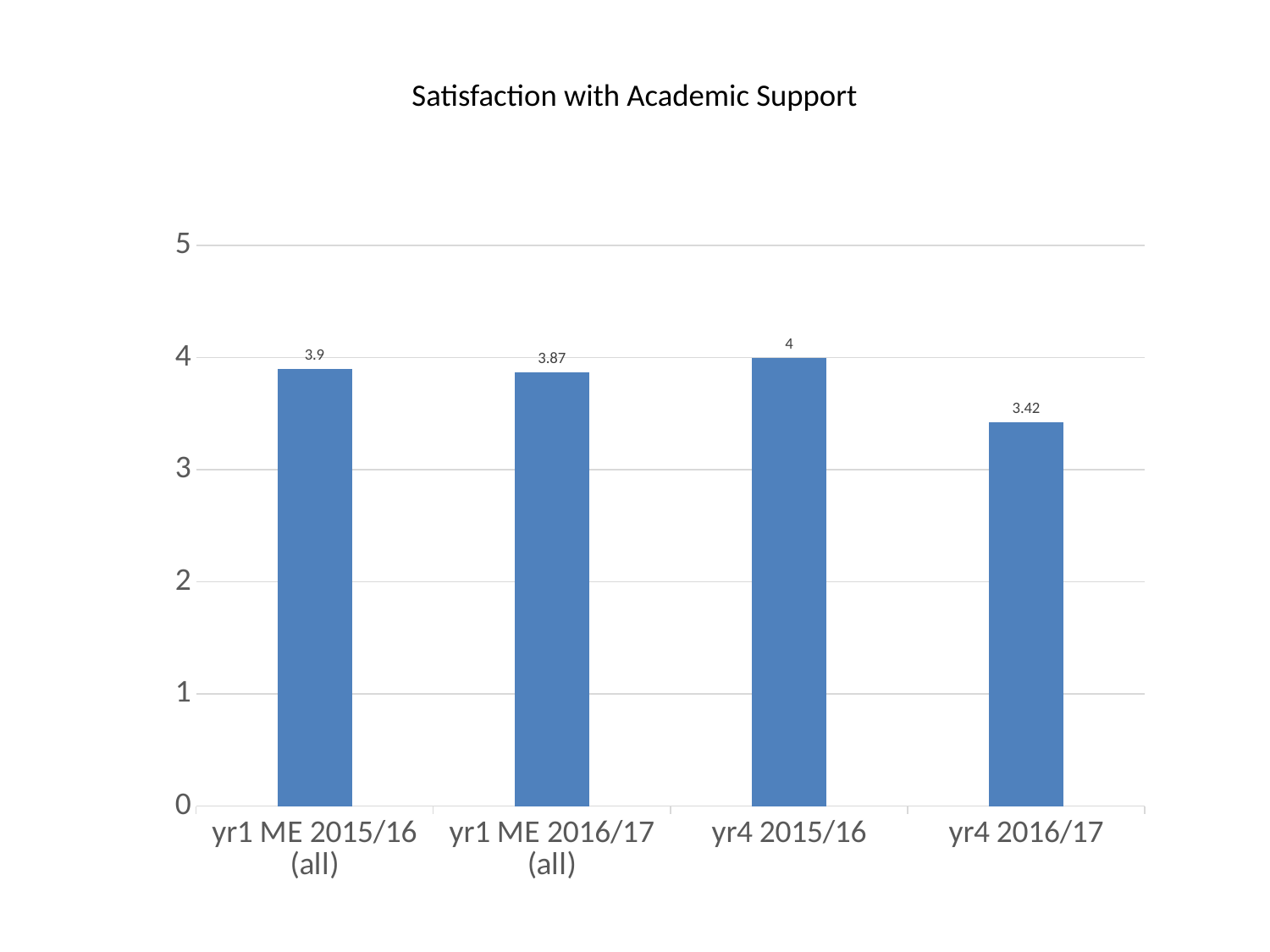
What is the value for yr4 2016/17? 3.42 How many categories are shown on the x axis? 4 Which category has the lowest value? yr4 2016/17 What is the value for yr1 ME 2015/16 (all)? 3.9 What is the difference between the values for yr4 2015/16 and yr4 2016/17? 0.58 Is the value for yr4 2016/17 greater or less than 4? less What is the value for yr4 2015/16? 4 Which category has the highest value? yr4 2015/16 What kind of chart is this? bar chart What is the value for yr1 ME 2016/17 (all)? 3.87 Which is larger, the value for yr4 2015/16 or the value for yr4 2016/17? yr4 2015/16 What is the difference between the values for yr1 ME 2015/16 (all) and yr1 ME 2016/17 (all)? 0.03